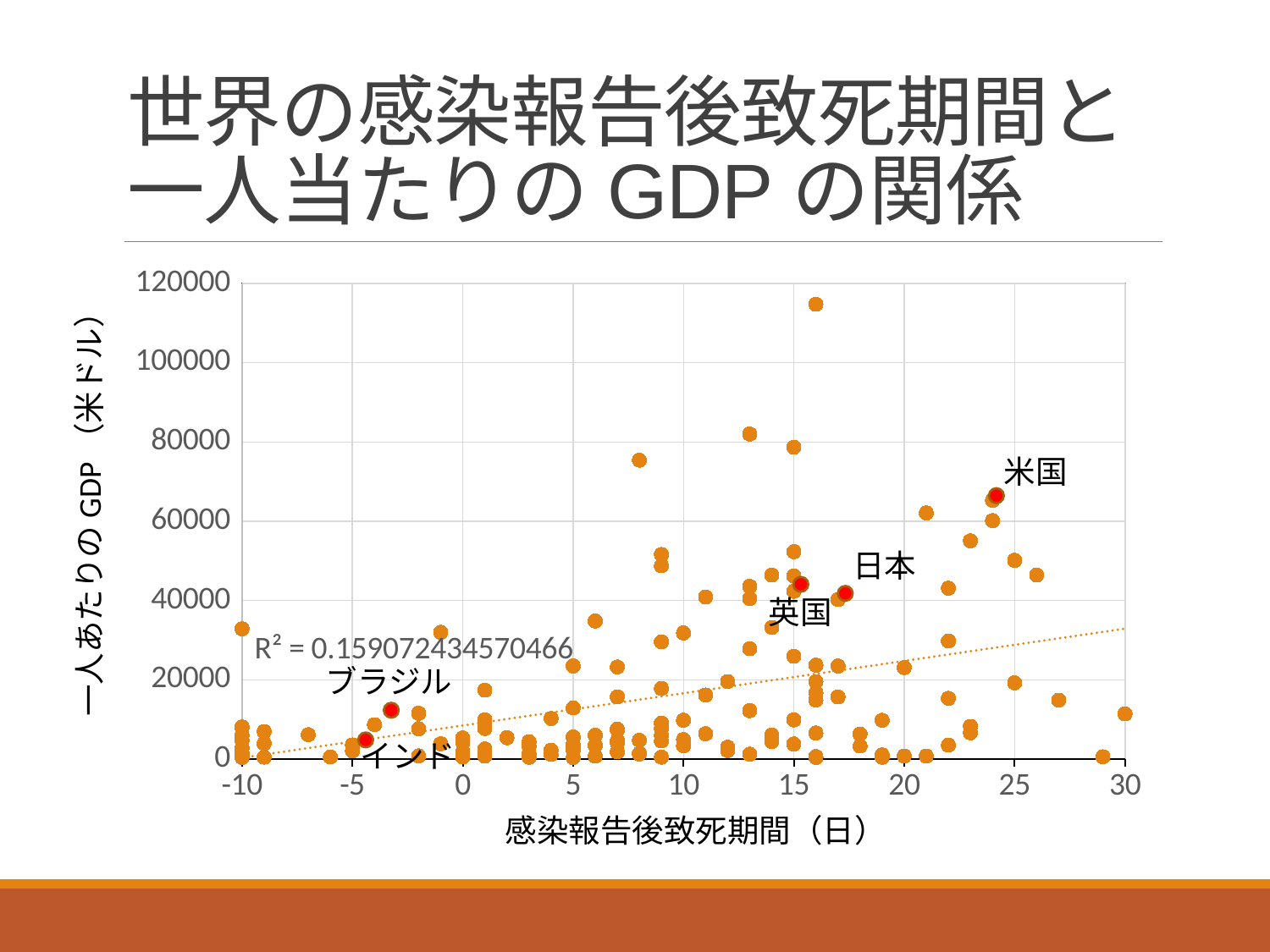
What kind of chart is shown on the slide? scatter chart What R² value is printed on the chart? R² = 0.159072434570466 Is the GDP per capita value for 日本 greater or less than 60000? less Is the x-axis value (感染報告後致死期間) for 米国 greater or less than 20? greater Is the GDP per capita value for 米国 greater or less than 60000? greater What is the title of the x axis of the chart? 感染報告後致死期間（日） Among the labeled countries (米国, 日本, 英国, ブラジル, インド), which has the lowest GDP per capita? インド Which has the higher GDP per capita, 米国 or 日本? 米国